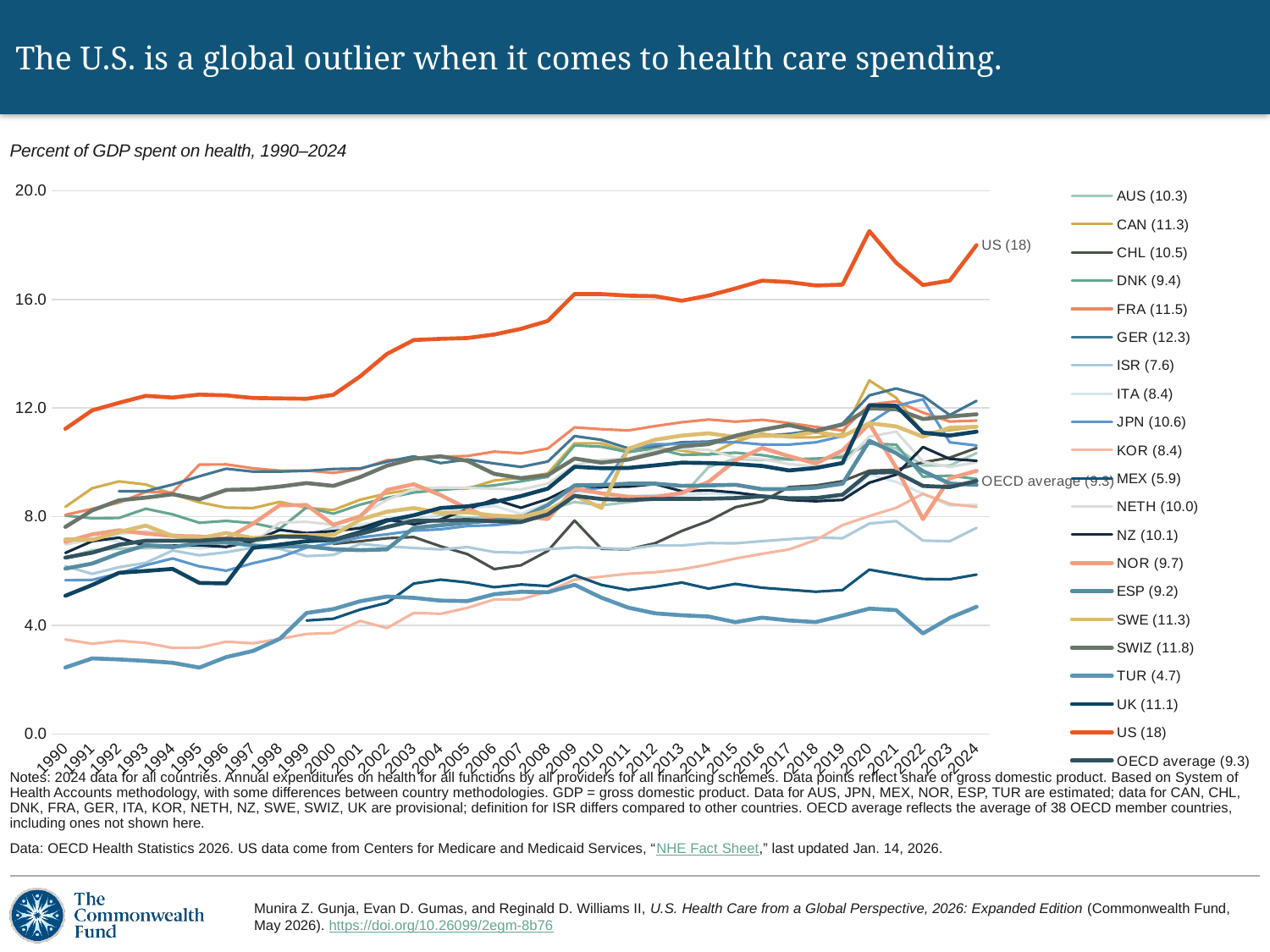
How many years are shown on the x axis? 35 What is the 2024 value shown in the legend for GER? 12.3 What is the 2024 value shown in the legend for TUR? 4.7 Which country has the lowest percent of GDP spent on health in 2024? TUR Which country has the highest percent of GDP spent on health in 2024? US Does the US line rise or fall from 1990 to 2024? Rise Which has a higher 2024 value, GER or SWIZ? GER What is the difference between the US 2024 value and the OECD average 2024 value? 8.7 Is the value for the US in 2020 greater or less than 16.0? greater What is the 2024 value shown in the legend for the US? 18 How many series does the legend list? 21 What kind of chart is shown on the slide? Line chart